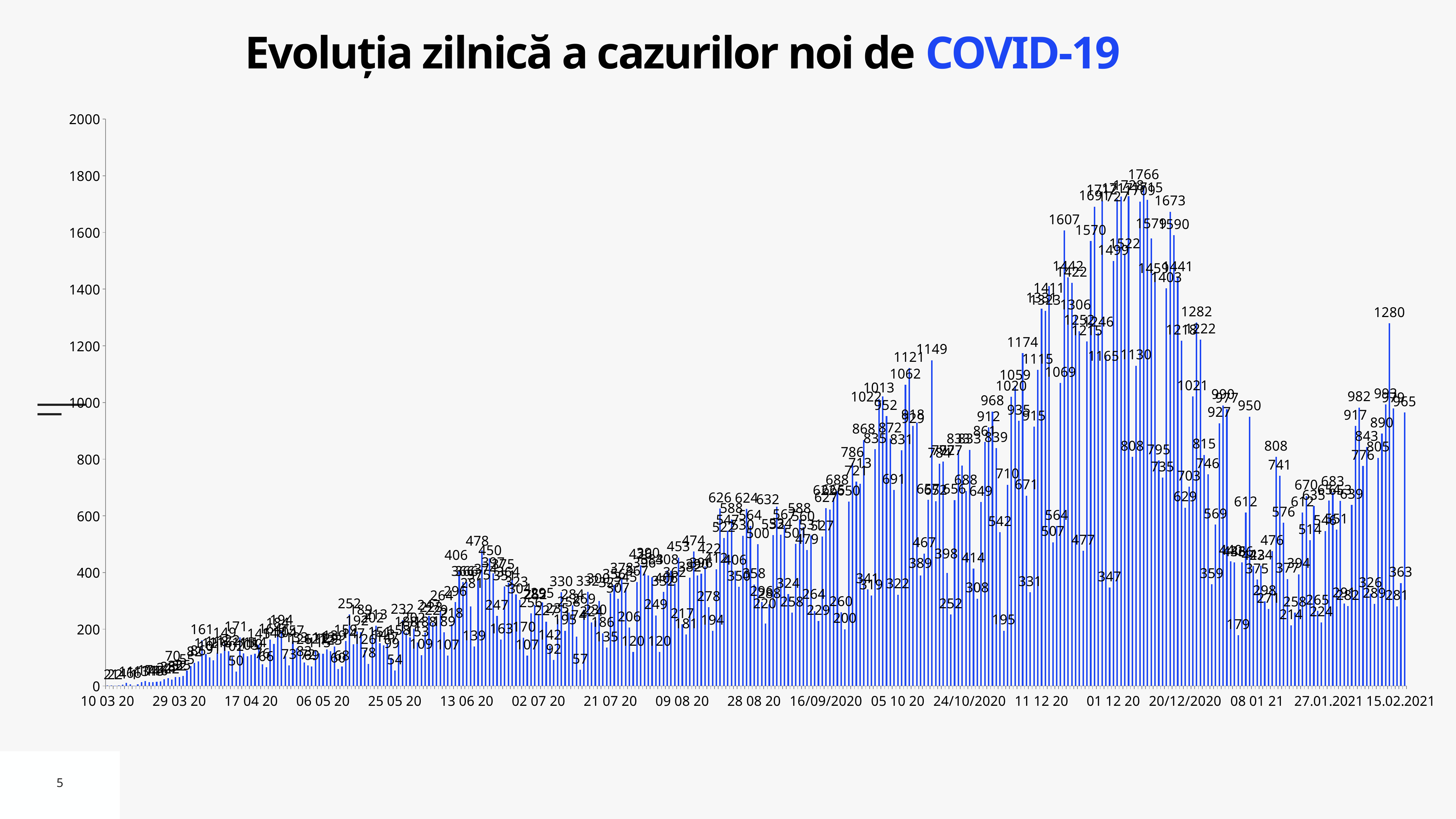
Is the highest value on the chart greater or less than 1600? greater What is the first date label on the horizontal axis? 10 03 20 What is the last date label on the horizontal axis? 15.02.2021 What kind of chart is shown on the slide? bar chart What is the maximum value shown on the vertical axis? 2000 What colour are the bars in the chart? blue What is the title of the chart? Evoluția zilnică a cazurilor noi de COVID-19 Is the highest value on the chart greater or less than 1800? less Which is larger: the peak value around 13 06 20 (478) or the peak value around 20/12/2020 (1766)? 1766 Do the daily values generally rise or fall from 10 03 20 to 01 12 20? rise What is the highest daily value labelled on the chart? 1766 What is the difference between the peak value 1766 and the value 1673 labelled just after it? 93